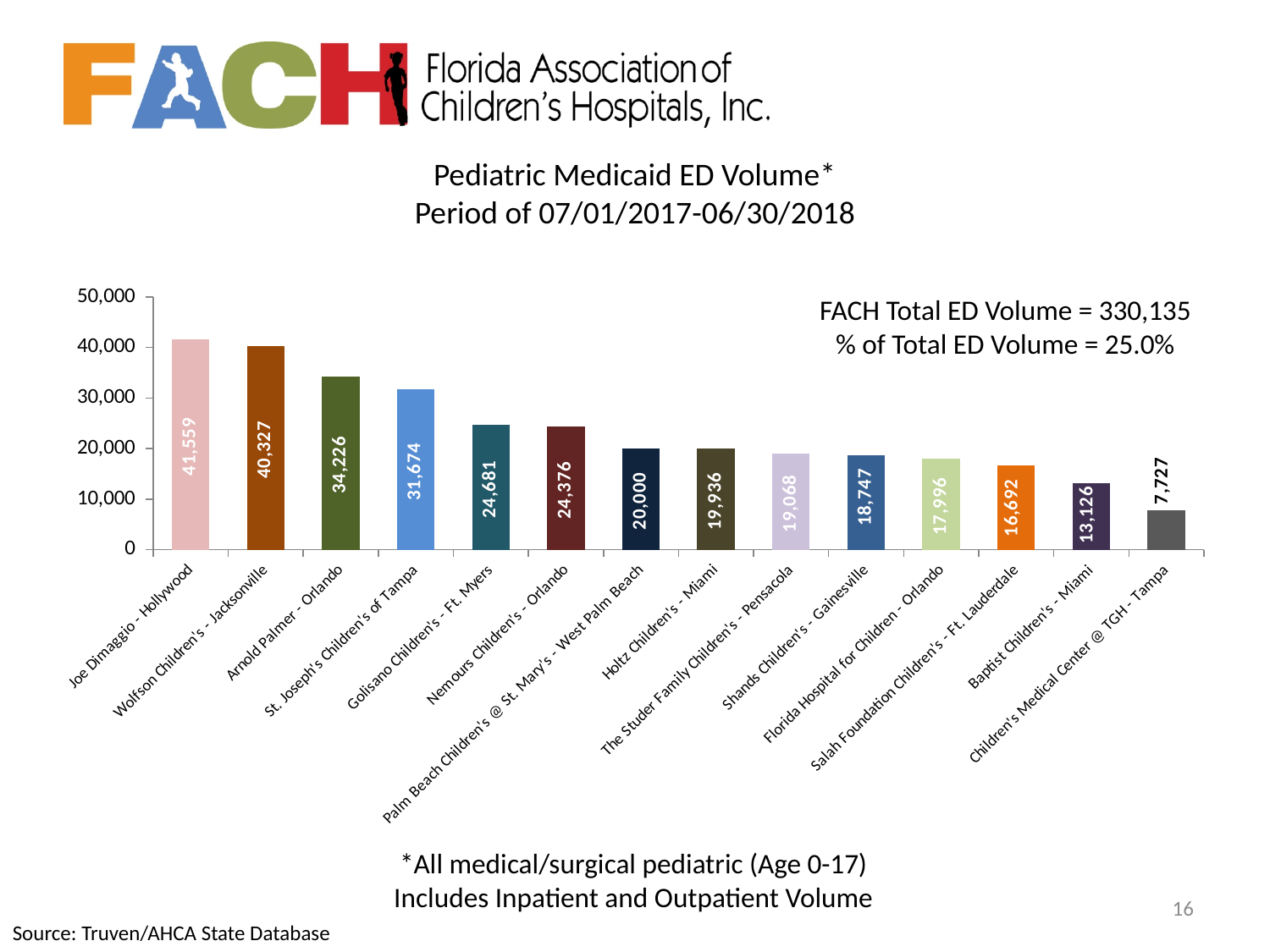
How many hospitals are shown in the chart? 14 What is the Pediatric Medicaid ED Volume for Joe Dimaggio - Hollywood? 41,559 Which hospital has the lowest Pediatric Medicaid ED Volume? Children's Medical Center @ TGH - Tampa What is the FACH Total ED Volume stated on the slide? 330,135 Which has a larger Pediatric Medicaid ED Volume, Arnold Palmer - Orlando or St. Joseph's Children's of Tampa? Arnold Palmer - Orlando What is the difference in Pediatric Medicaid ED Volume between Joe Dimaggio - Hollywood and Wolfson Children's - Jacksonville? 1,232 Is the value for Baptist Children's - Miami greater or less than 20,000? less What is the Pediatric Medicaid ED Volume for Holtz Children's - Miami? 19,936 What kind of chart is shown on the slide? bar chart Do the values rise or fall from left to right across the chart? fall Which hospital has the highest Pediatric Medicaid ED Volume? Joe Dimaggio - Hollywood What is the Pediatric Medicaid ED Volume for Shands Children's - Gainesville? 18,747